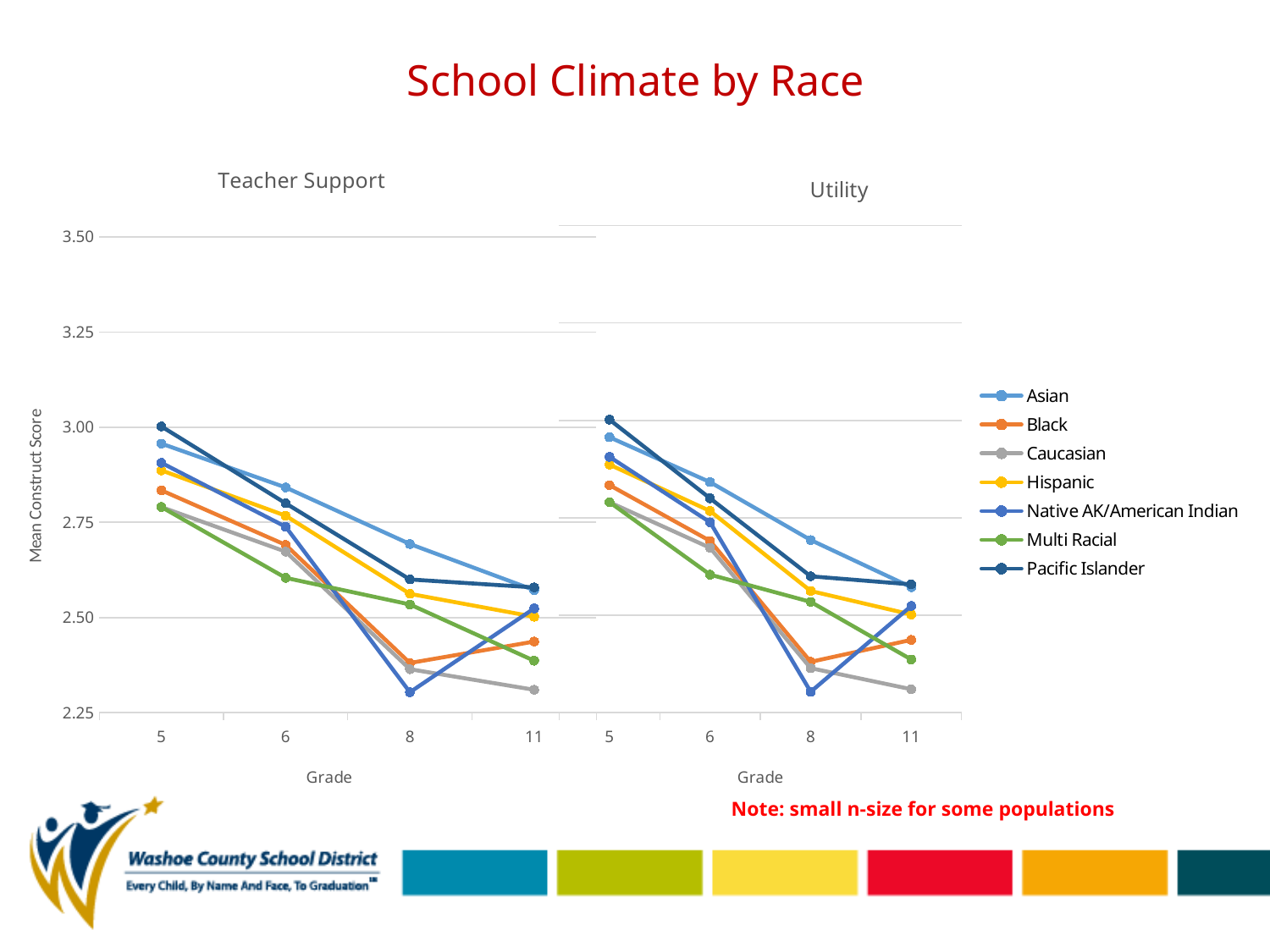
In the Utility chart, is the value for Caucasian at grade 11 greater or less than 2.50? less In the Teacher Support chart, which group has the lowest value at grade 11? Caucasian What kind of chart is the Teacher Support chart? line chart In the Teacher Support chart, does the Asian line rise or fall from grade 5 to grade 11? fall In the Teacher Support chart, which group has the lowest value at grade 8? Native AK/American Indian In the Teacher Support chart, is the value for Asian at grade 8 greater or less than 2.50? greater What is the label on the y axis of the Teacher Support chart? Mean Construct Score How many grade levels are plotted on the x axis of the Utility chart? 4 In the Utility chart, which group has the highest value at grade 8? Asian What is the title of the chart on the right side of the slide? Utility How many series does the legend list? 7 In the Utility chart, which is larger at grade 11, the value for Black or the value for Caucasian? Black